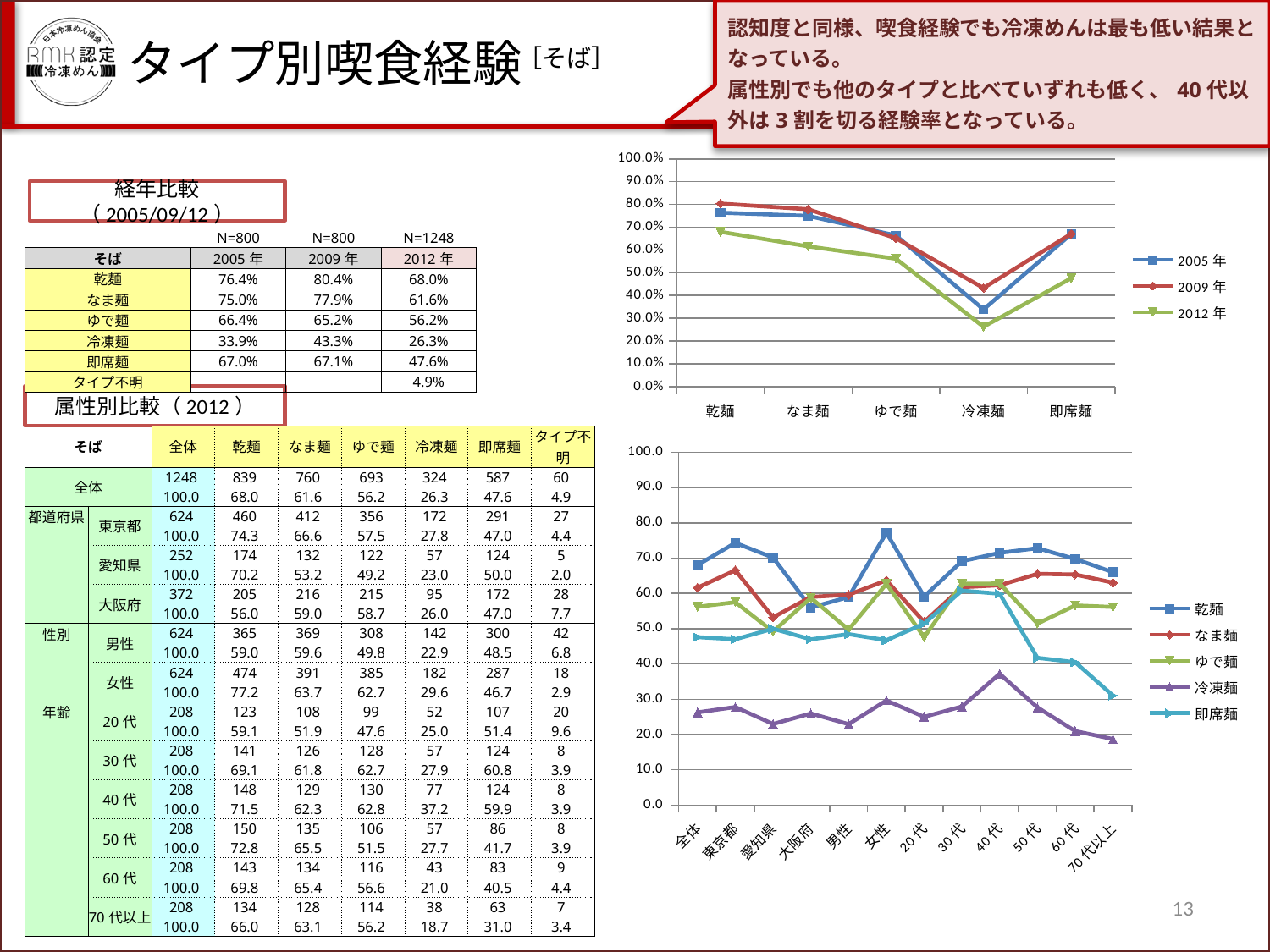
In the upper chart (経年比較), which category has the lowest value for the 2012年 series? 冷凍麺 In the upper chart (経年比較), what is the value for 冷凍麺 in the 2009年 series? 43.3% How many series does the legend of the upper chart (経年比較) list? 3 In the upper chart (経年比較), which series has the larger value for 乾麺: 2009年 or 2012年? 2009年 How many series does the legend of the lower chart (属性別比較 2012) list? 5 What kind of chart is the upper chart (経年比較) on the slide? line chart In the upper chart (経年比較), is the value for 乾麺 in the 2005年 series greater or less than 70.0%? greater How many categories are shown on the x axis of the lower chart (属性別比較 2012)? 12 In the lower chart (属性別比較 2012), which series has the lowest value at 全体? 冷凍麺 In the lower chart (属性別比較 2012), is the value for 冷凍麺 at 70代以上 greater or less than 20.0? less How many categories are shown on the x axis of the upper chart (経年比較)? 5 In the lower chart (属性別比較 2012), which category has the highest value for the 乾麺 series? 女性